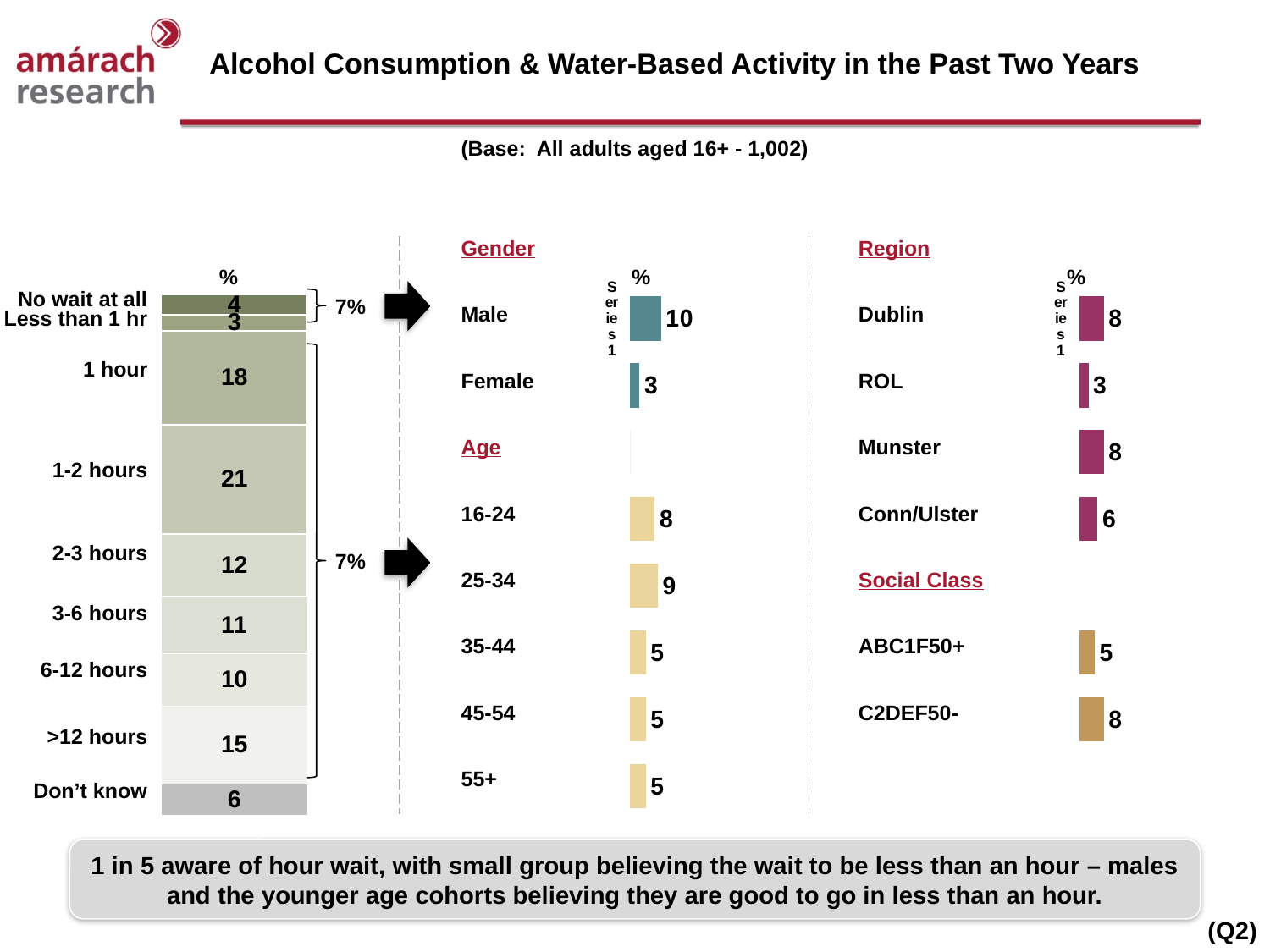
In the Region chart, which region has the lowest value? ROL In the left-hand stacked bar chart of wait times, what is the value for '1-2 hours'? 21 In the left-hand stacked bar chart of wait times, what is the difference between the values for '1 hour' and '2-3 hours'? 6 In the Age chart, what is the value for 16-24? 8 In the left-hand stacked bar chart of wait times, which category has the highest value? 1-2 hours In the Age chart, which age group has the highest value? 25-34 In the Region chart, what is the difference between the values for Dublin and Conn/Ulster? 2 What type of chart is the Region chart? Bar chart In the Gender chart, what is the value for Male? 10 In the left-hand stacked bar chart of wait times, how many categories are shown? 9 In the Social Class chart, what is the value for C2DEF50-? 8 In the Gender chart, which is larger, the value for Male or Female? Male